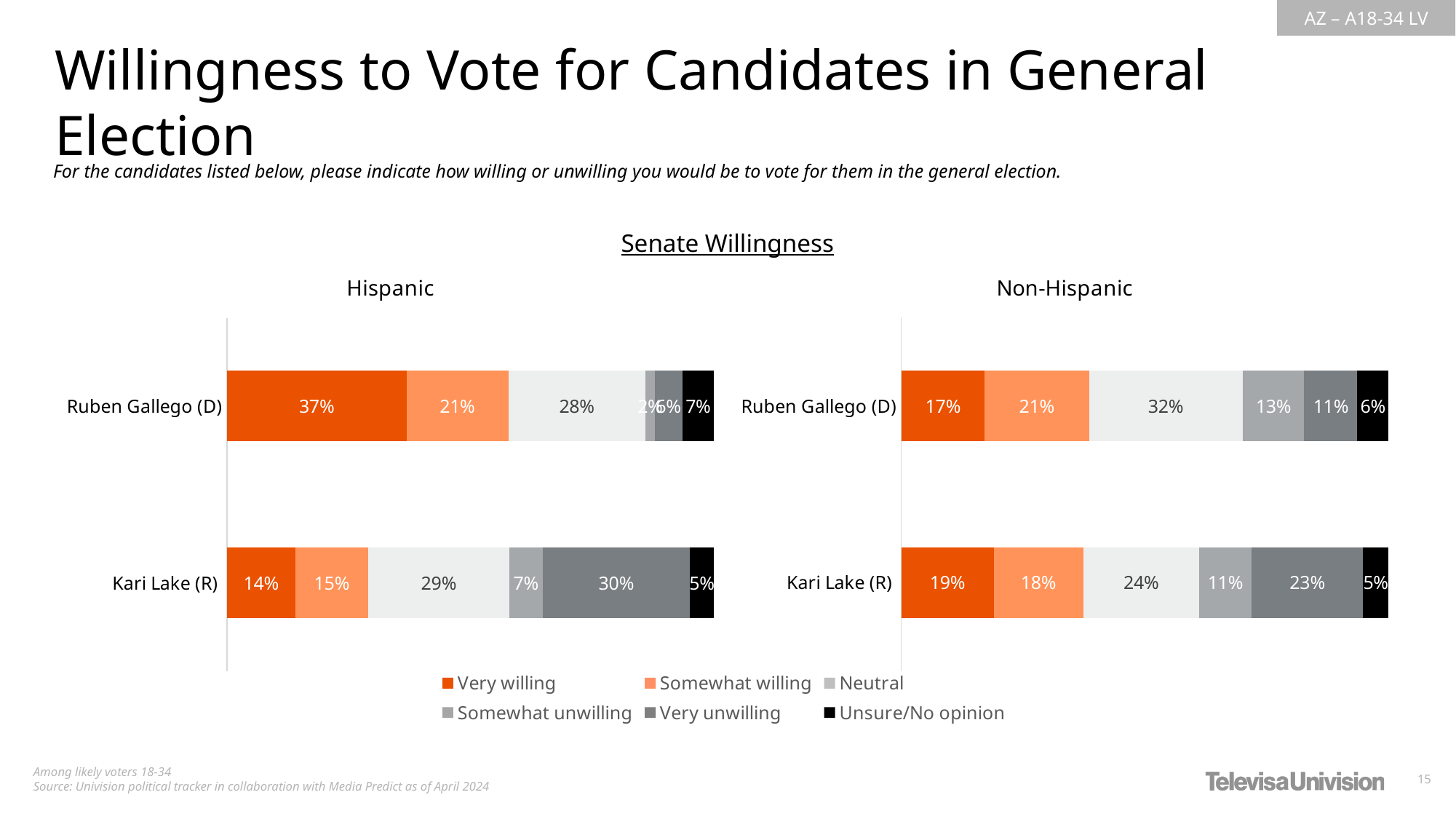
In the Hispanic chart, what is the difference between the very willing shares for Ruben Gallego (D) and Kari Lake (R)? 23 percentage points In the Hispanic chart, what percentage of respondents are very unwilling to vote for Kari Lake (R)? 30% In the Hispanic chart, what is the combined share of very willing and somewhat willing for Kari Lake (R)? 29% In the Non-Hispanic chart, what is the difference between the very unwilling shares for Kari Lake (R) and Ruben Gallego (D)? 12 percentage points What kind of chart is used for the Non-Hispanic data? Stacked bar chart How many series does the legend list? 6 In the Non-Hispanic chart, what percentage of respondents are somewhat willing to vote for Kari Lake (R)? 18% How many candidates are shown in the Hispanic chart? 2 In the Hispanic chart, what percentage of respondents are very willing to vote for Ruben Gallego (D)? 37% What is the title shown above the two charts? Senate Willingness In the Non-Hispanic chart, what percentage of respondents are neutral on Ruben Gallego (D)? 32% In the Non-Hispanic chart, which candidate has the larger very willing share, Ruben Gallego (D) or Kari Lake (R)? Kari Lake (R)